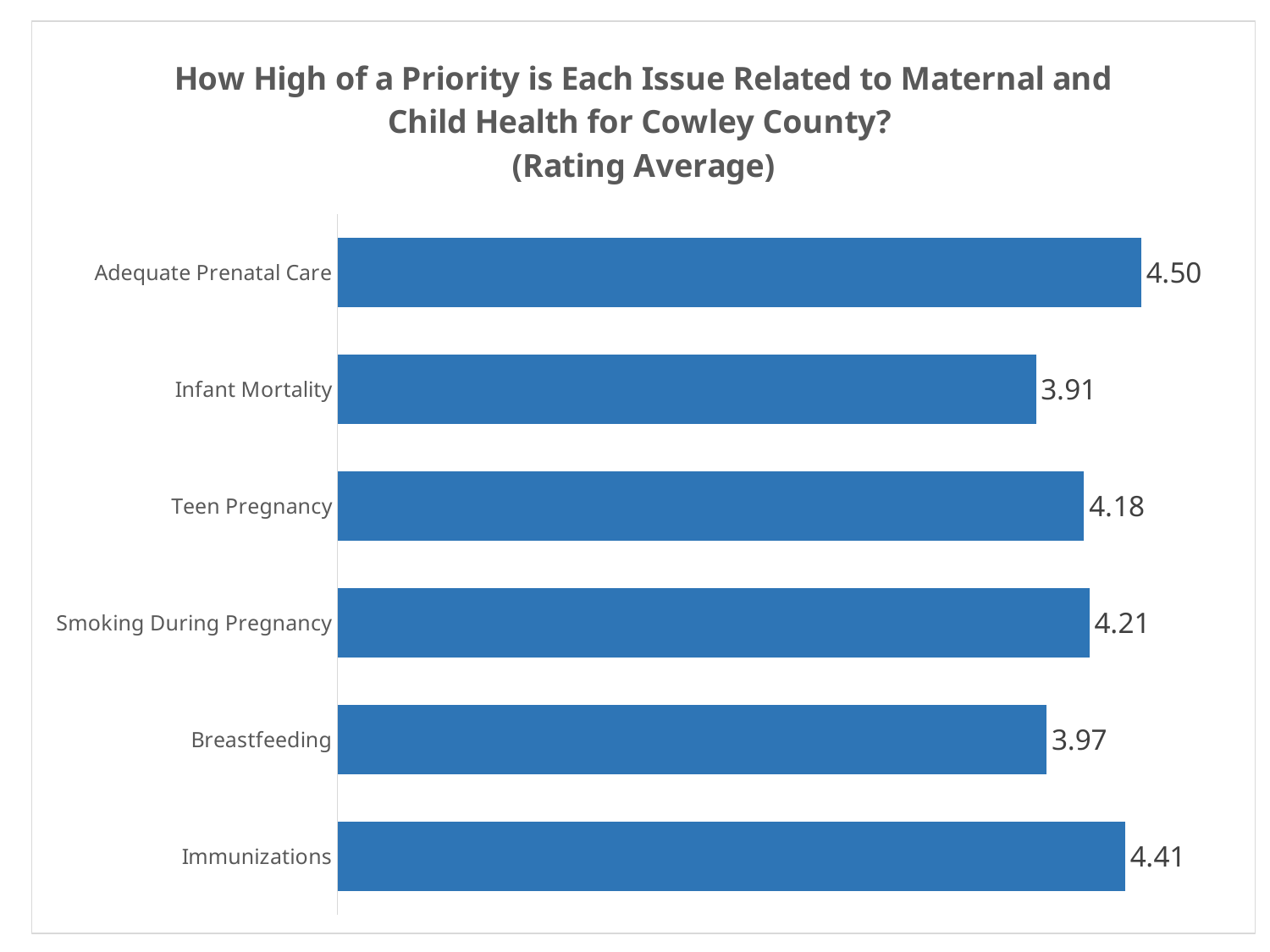
What is the difference between the rating averages for Adequate Prenatal Care and Infant Mortality? 0.59 What kind of chart is shown on the slide? Bar chart How many issues are shown in the chart? 6 Which has a higher rating average, Teen Pregnancy or Breastfeeding? Teen Pregnancy Which issue has the highest rating average? Adequate Prenatal Care What is the rating average for Smoking During Pregnancy? 4.21 What is the rating average for Infant Mortality? 3.91 What is the rating average for Immunizations? 4.41 What is the rating average for Adequate Prenatal Care? 4.50 What colour are the bars in the chart? Blue What is the difference between the rating averages for Immunizations and Breastfeeding? 0.44 Which issue has the lowest rating average? Infant Mortality